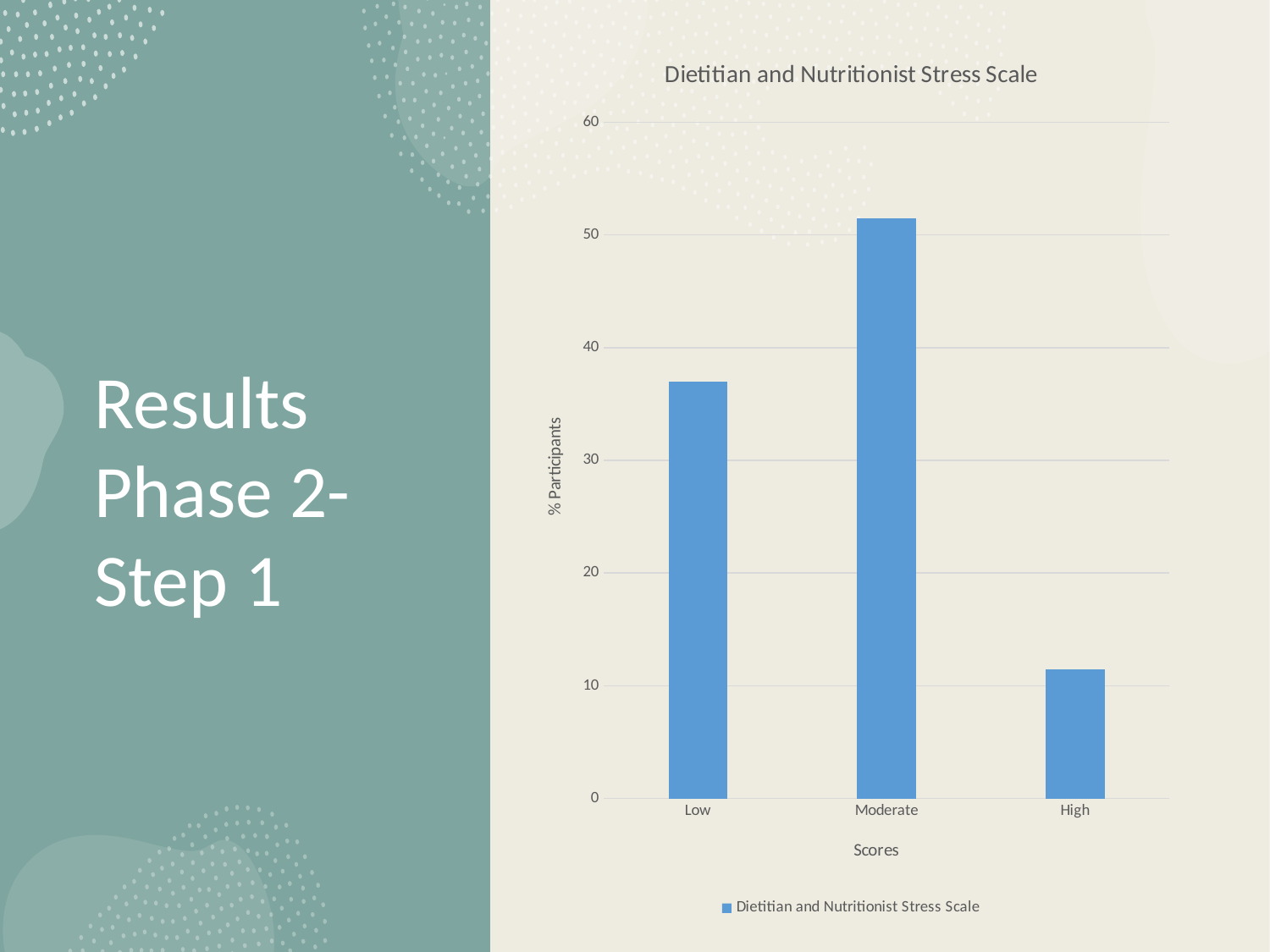
Which score category has the highest percentage of participants? Moderate How many series does the legend list? 1 Is the value for Moderate greater or less than 50? greater What is the title of the chart? Dietitian and Nutritionist Stress Scale What kind of chart is shown on the slide? bar chart How many categories are shown on the x axis of the chart? 3 Is the value for High greater or less than 10? greater What is the label of the y axis? % Participants Is the value for Low greater or less than 40? less Which score category has the lowest percentage of participants? High Which is larger, the value for Low or the value for High? Low